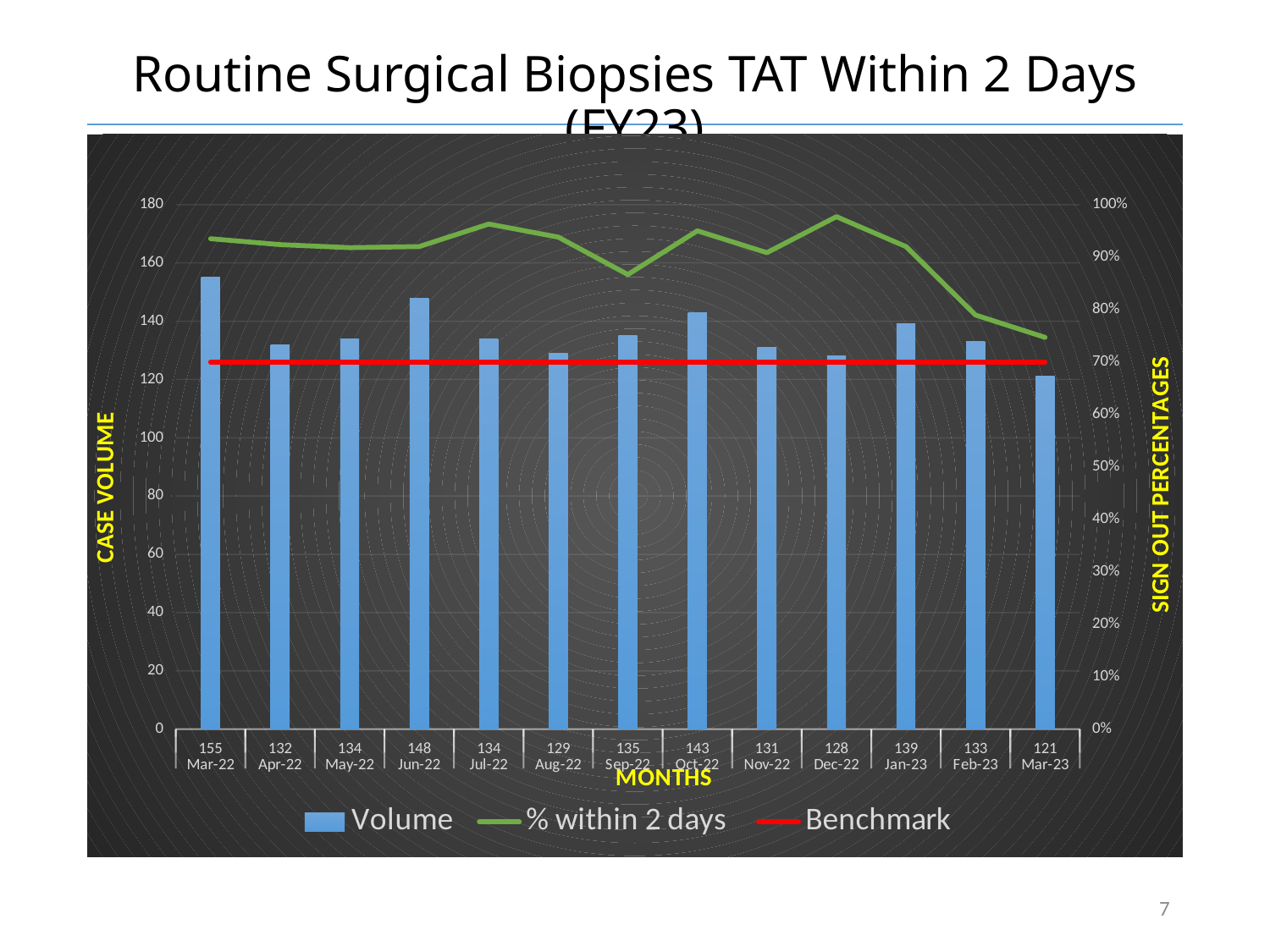
Is the % within 2 days value for Dec-22 greater or less than 90%? greater How many series does the legend list? 3 Which month has the larger Volume, Jun-22 or Oct-22? Jun-22 Is the % within 2 days value for Mar-23 greater or less than 80%? less Which month has the lowest Volume? Mar-23 What is the Volume for Mar-22? 155 What is the Volume for Jun-22? 148 Does the % within 2 days line rise or fall from Dec-22 to Mar-23? fall Which month has the highest Volume? Mar-22 What is the difference in Volume between Mar-22 and Mar-23? 34 What is the title of the right-hand vertical axis? SIGN OUT PERCENTAGES How many months are shown on the x axis? 13